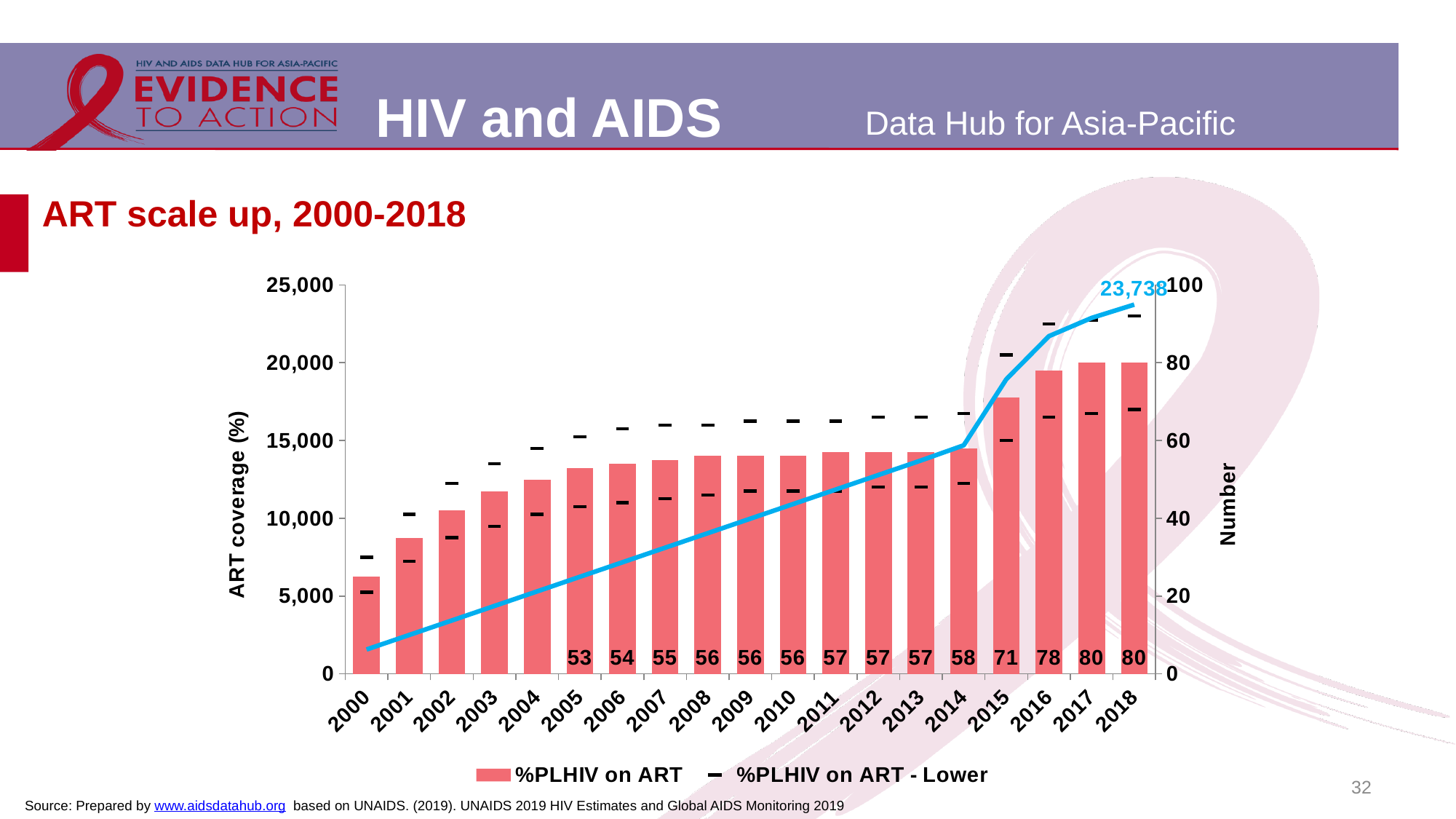
How many series does the legend list? 2 Which year has the lowest %PLHIV on ART bar? 2000 What is the %PLHIV on ART value shown for 2015? 71 Which year has a higher %PLHIV on ART value, 2016 or 2012? 2016 Is the %PLHIV on ART bar for 2000 greater or less than 40 on the right-hand axis? less How many years are shown on the x axis? 19 What is the %PLHIV on ART value shown for 2018? 80 What is the highest %PLHIV on ART value labelled on the bars? 80 What is the difference between the %PLHIV on ART values for 2018 and 2014? 22 Do the %PLHIV on ART bars generally rise or fall from 2000 to 2018? rise What value is labelled at the end of the blue line in 2018? 23,738 What is the %PLHIV on ART value shown for 2005? 53